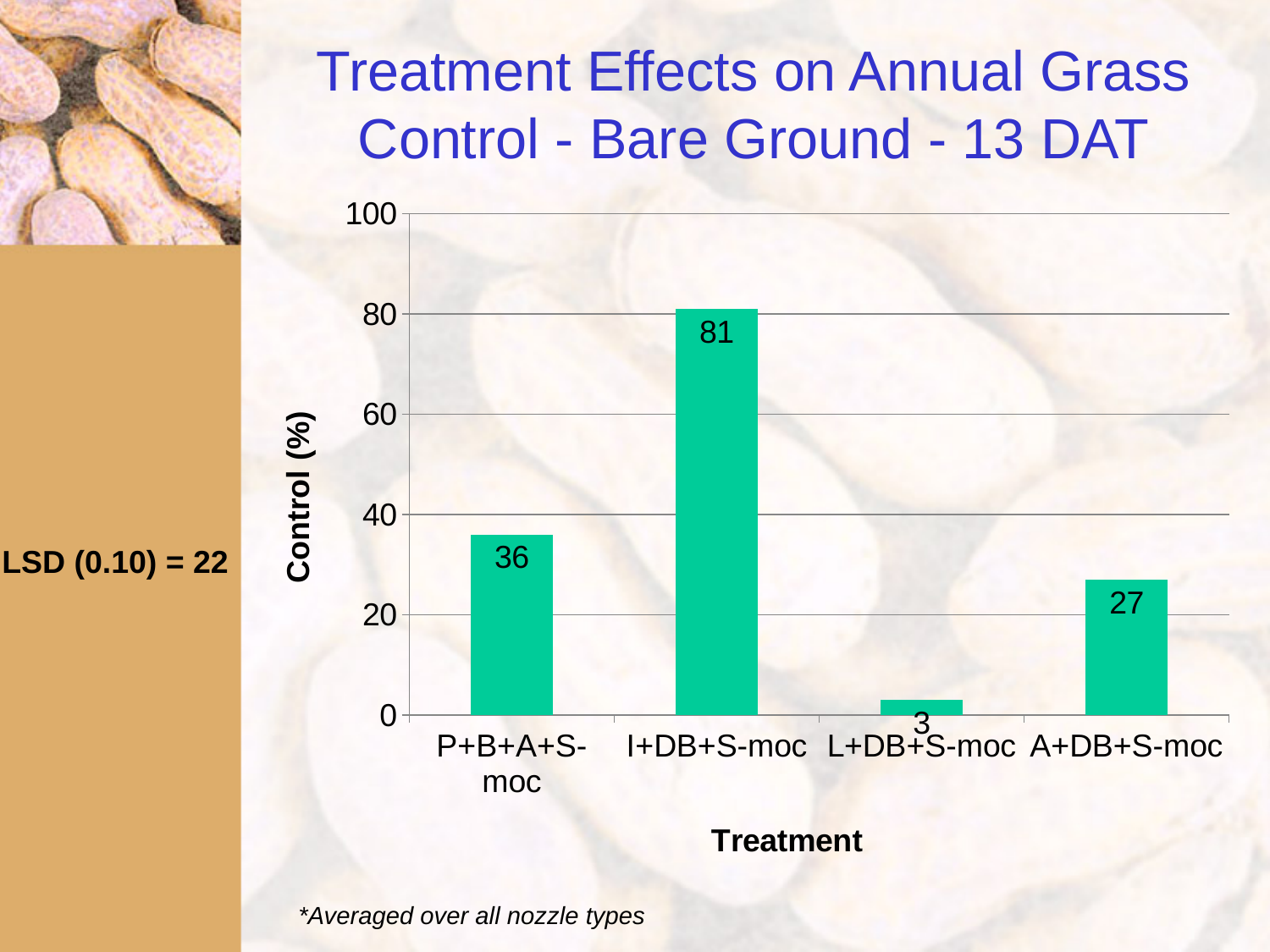
What is the control (%) value for the P+B+A+S-moc treatment? 36 Is the value for I+DB+S-moc greater or less than 80? greater What is the control (%) value for the A+DB+S-moc treatment? 27 How many treatments are shown on the chart? 4 Which has a higher control (%), P+B+A+S-moc or A+DB+S-moc? P+B+A+S-moc What kind of chart is shown on the slide? Bar chart Which treatment has the highest control (%)? I+DB+S-moc What is the control (%) value for the L+DB+S-moc treatment? 3 What is the control (%) value for the I+DB+S-moc treatment? 81 Which treatment has the lowest control (%)? L+DB+S-moc What is the difference in control (%) between I+DB+S-moc and P+B+A+S-moc? 45 What is the difference in control (%) between P+B+A+S-moc and A+DB+S-moc? 9